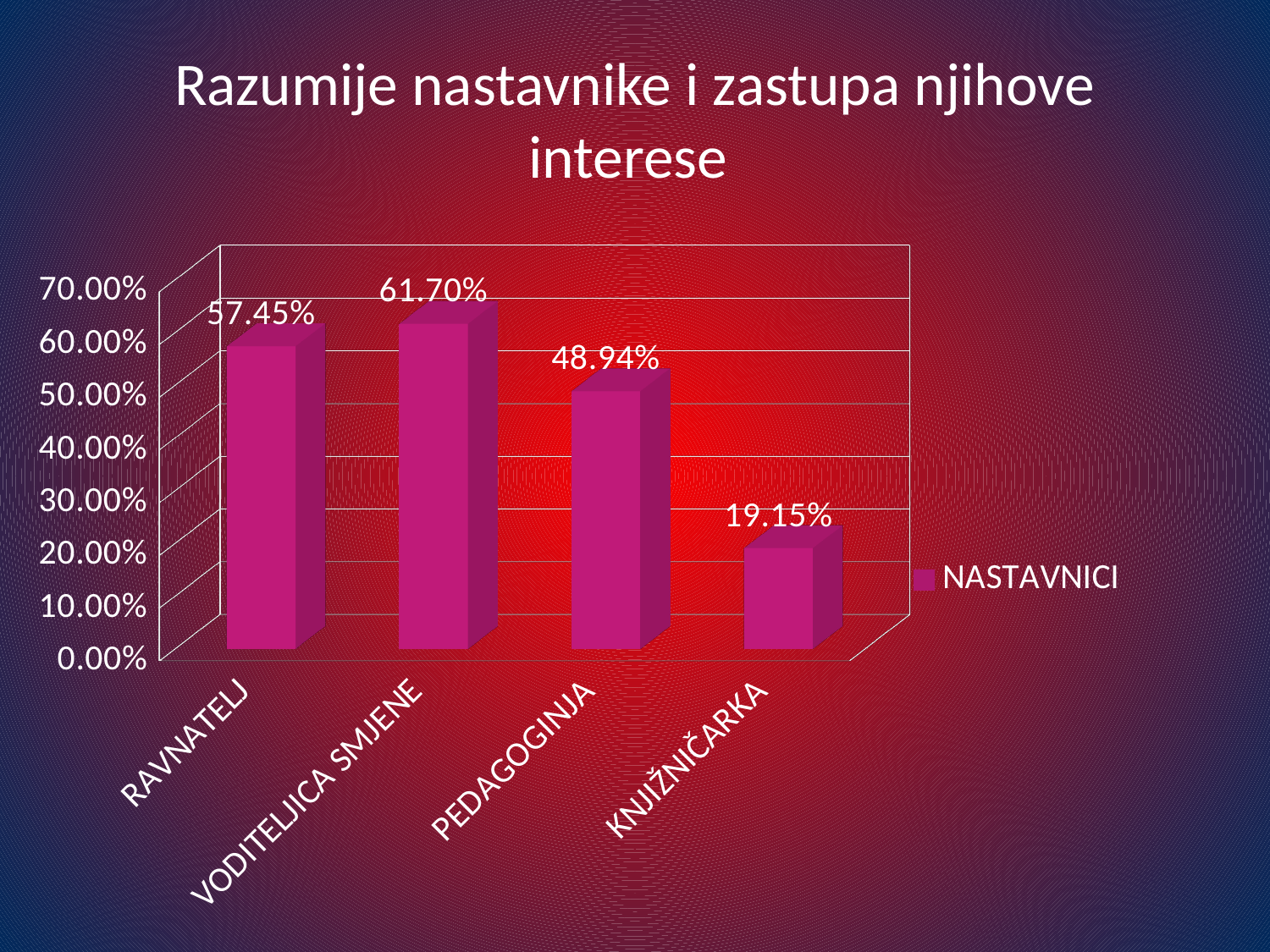
What is the value for VODITELJICA SMJENE? 61.70% Which is larger, the value for PEDAGOGINJA or the value for KNJIŽNIČARKA? PEDAGOGINJA What is the difference between the values for VODITELJICA SMJENE and RAVNATELJ? 4.25% What is the value for KNJIŽNIČARKA? 19.15% What is the value for RAVNATELJ? 57.45% How many categories are shown on the x axis? 4 How many series does the legend list? 1 Which category has the highest value? VODITELJICA SMJENE Which category has the lowest value? KNJIŽNIČARKA What kind of chart is shown on the slide? bar chart What is the name of the series in the legend? NASTAVNICI What is the value for PEDAGOGINJA? 48.94%